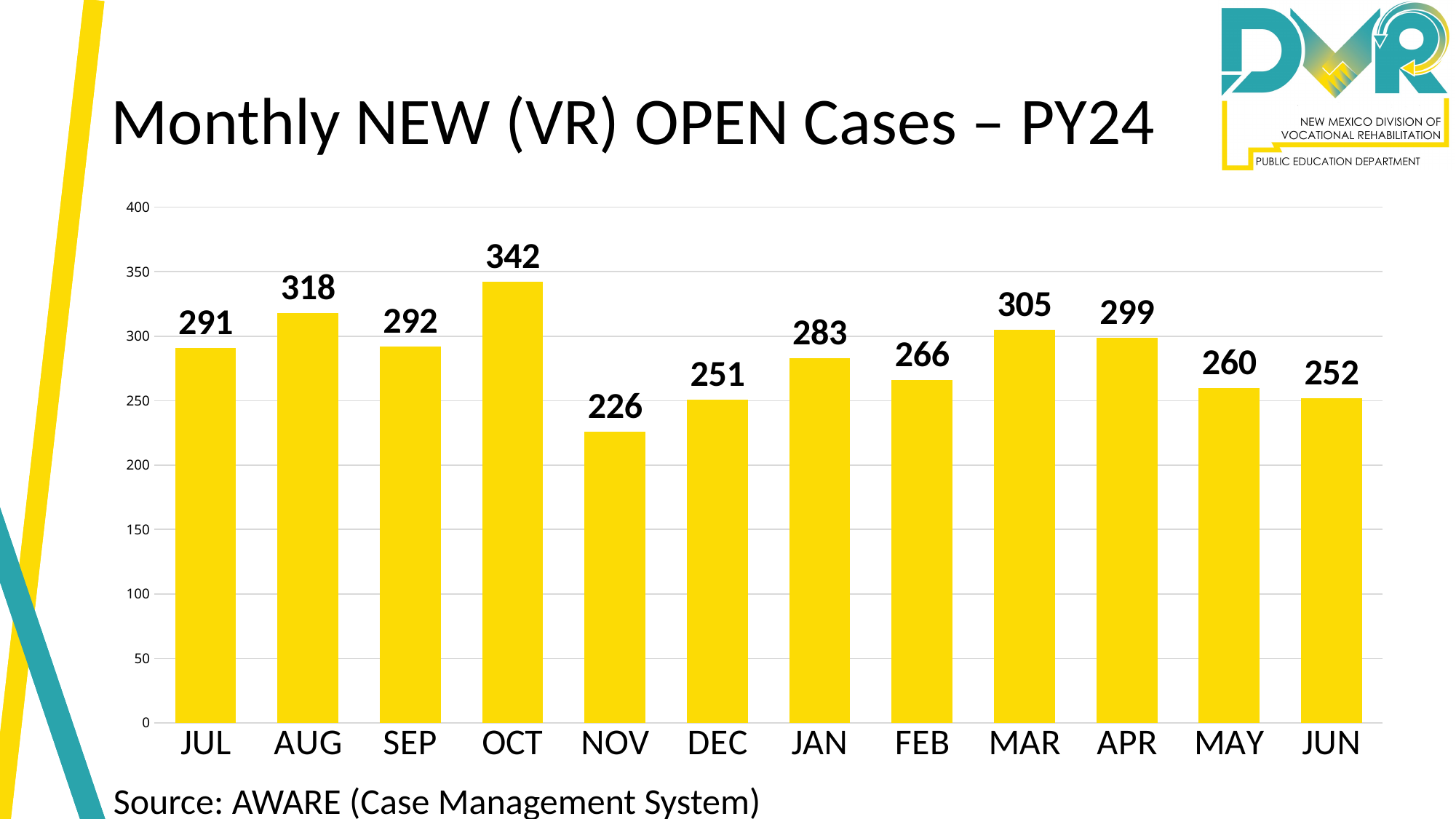
Which month has the lowest number of new open cases? NOV What is the value for NOV? 226 What is the title of the chart? Monthly NEW (VR) OPEN Cases – PY24 Is the value for JAN greater or less than 250? greater Which month has the highest number of new open cases? OCT Which is larger, the value for APR or the value for MAY? APR How many months are shown on the x axis? 12 What kind of chart is shown on the slide? Bar chart What is the value for OCT? 342 What is the difference between the values for OCT and NOV? 116 What is the value for MAR? 305 What is the difference between the values for AUG and JUL? 27